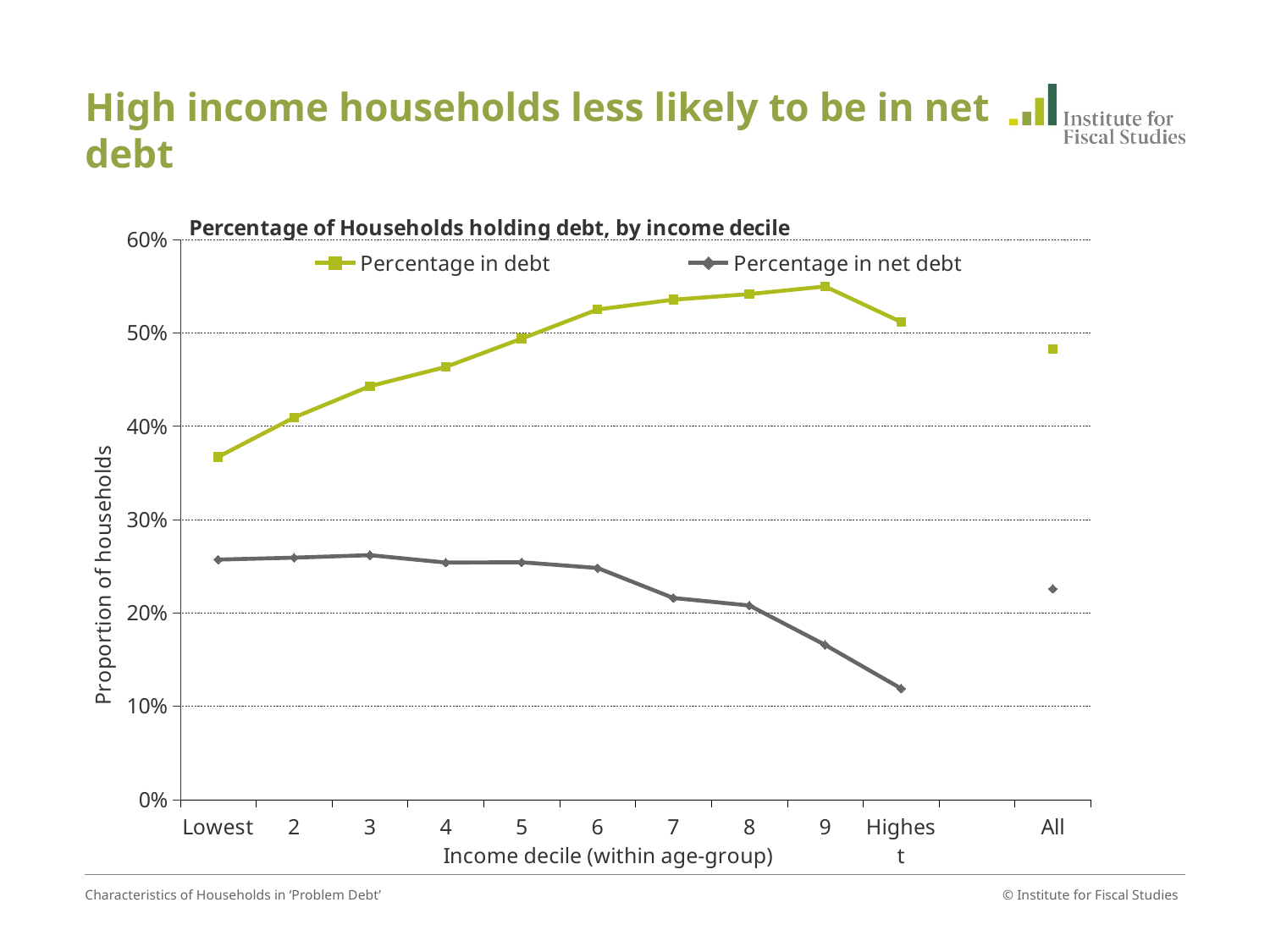
Which is larger for decile 4: Percentage in debt or Percentage in net debt? Percentage in debt Which income decile has the lowest value for Percentage in net debt? Highest What type of chart is shown on the slide? line chart Is the value for Percentage in net debt for the Highest decile greater or less than 10%? greater Which income decile has the lowest value for Percentage in debt? Lowest How many income decile categories are shown on the x axis, including 'All'? 11 Which income decile has the highest value for Percentage in debt? 9 Does the Percentage in net debt rise or fall from the Lowest decile to the Highest decile? fall How many series does the legend list? 2 Is the value for Percentage in debt for decile 6 greater or less than 50%? greater Is the value for Percentage in net debt for decile 9 greater or less than 20%? less